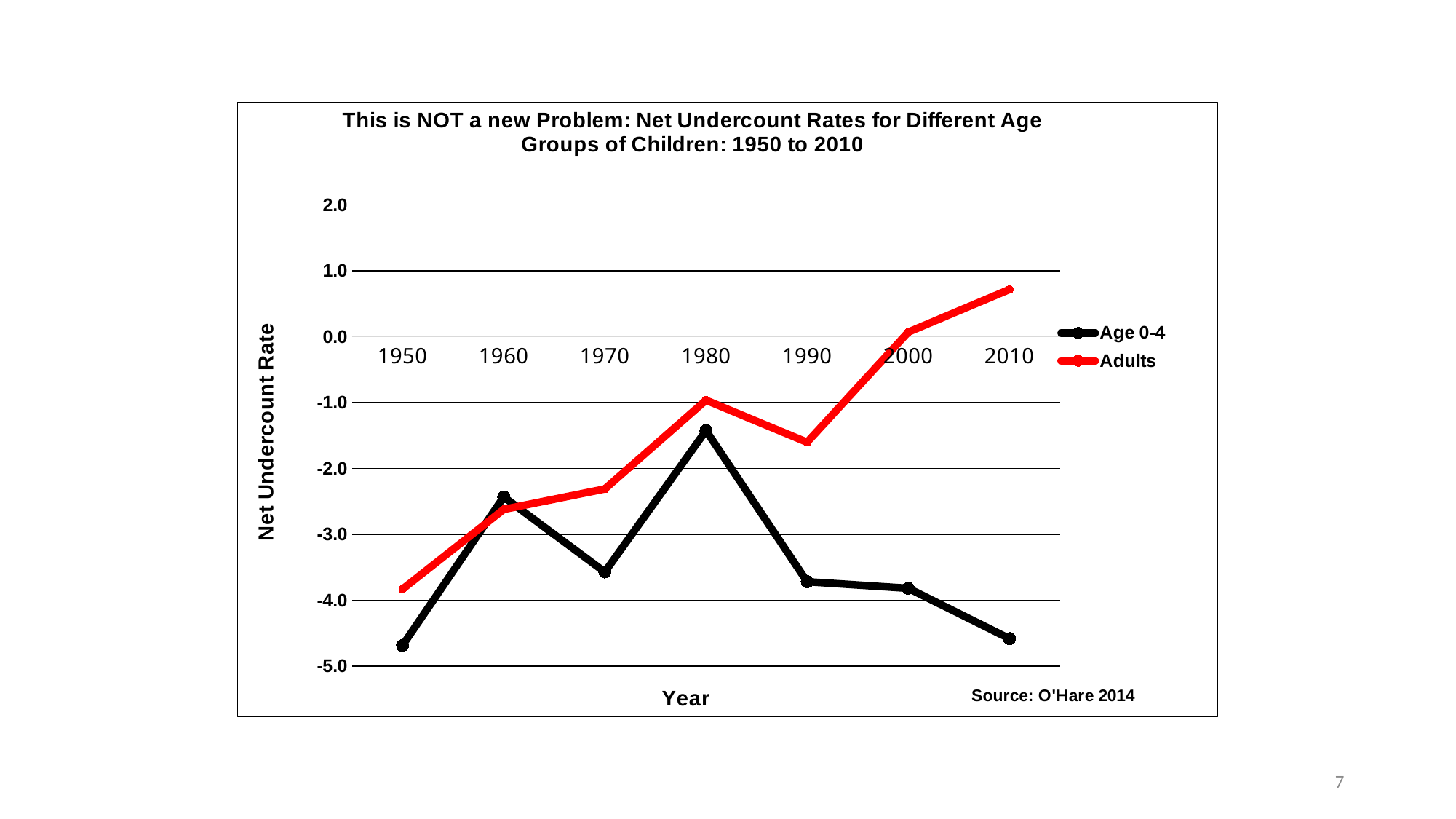
In which year does the Age 0-4 series reach its highest value? 1980 In which year does the Adults series have its lowest value? 1950 In 2010, which series has the larger value, Age 0-4 or Adults? Adults What colour is the line for the Adults series? Red Is the value for Adults in 2010 greater or less than 0.0? greater How many series does the legend list? 2 What kind of chart is shown on the slide? Line chart Is the value for Age 0-4 in 1980 greater or less than -2.0? greater How many years are plotted along the x axis? 7 Does the Adults series generally rise or fall from 1950 to 2010? Rise Is the value for Age 0-4 in 1950 greater or less than -4.0? less In which year does the Adults series reach its highest value? 2010